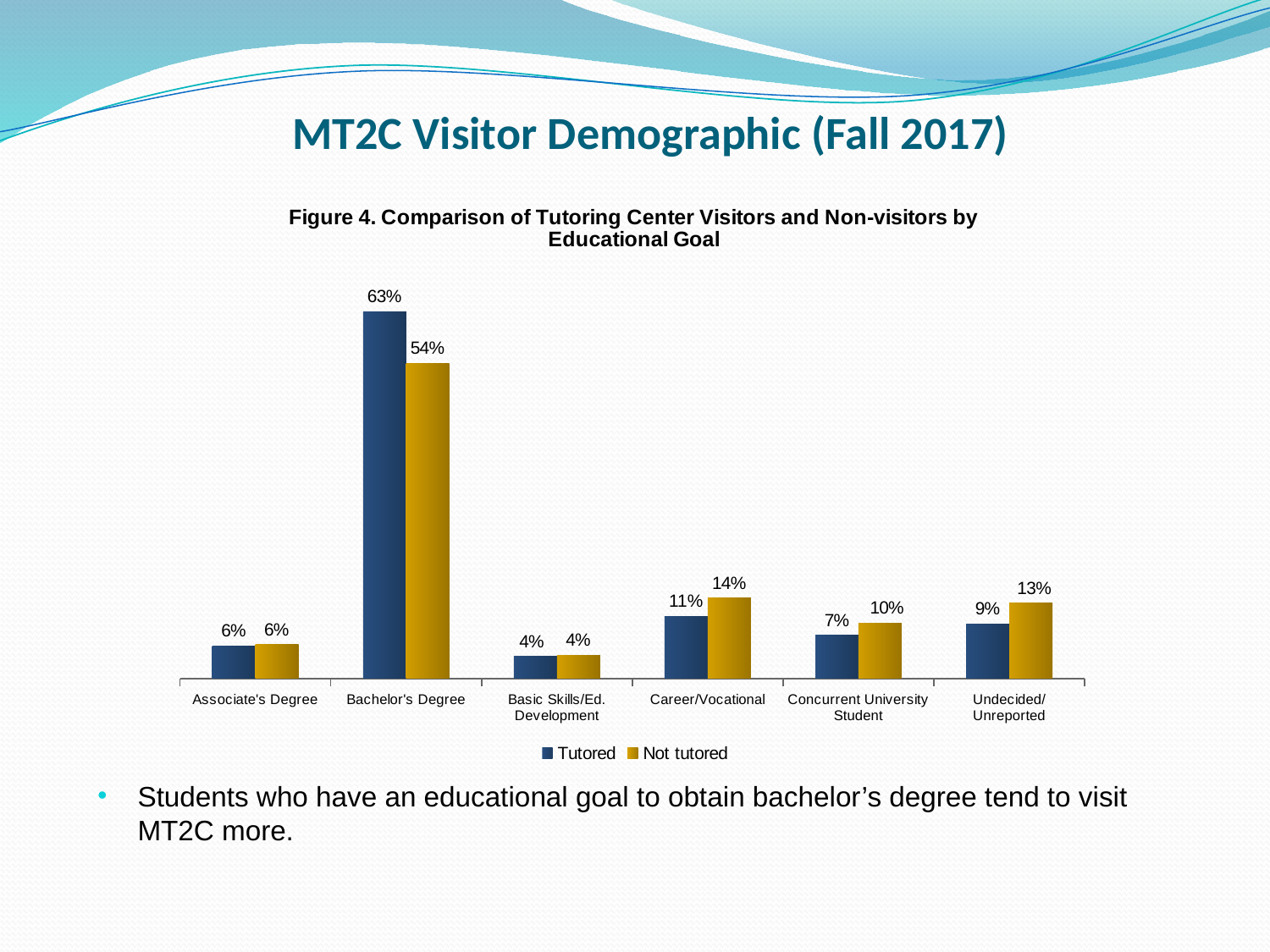
Which category has the lowest Not tutored value? Basic Skills/Ed. Development What is the Tutored value for Bachelor's Degree? 63% What is the difference between the Tutored and Not tutored values for Bachelor's Degree? 9% What is the Not tutored value for Career/Vocational? 14% Which is larger for Undecided/Unreported, the Tutored value or the Not tutored value? Not tutored How many educational goal categories are shown on the x axis? 6 What kind of chart is shown on the slide? Bar chart What is the Tutored value for Concurrent University Student? 7% What is the Not tutored value for Undecided/Unreported? 13% What is the figure title of the chart? Figure 4. Comparison of Tutoring Center Visitors and Non-visitors by Educational Goal How many series does the legend list? 2 Which category has the highest Tutored value? Bachelor's Degree